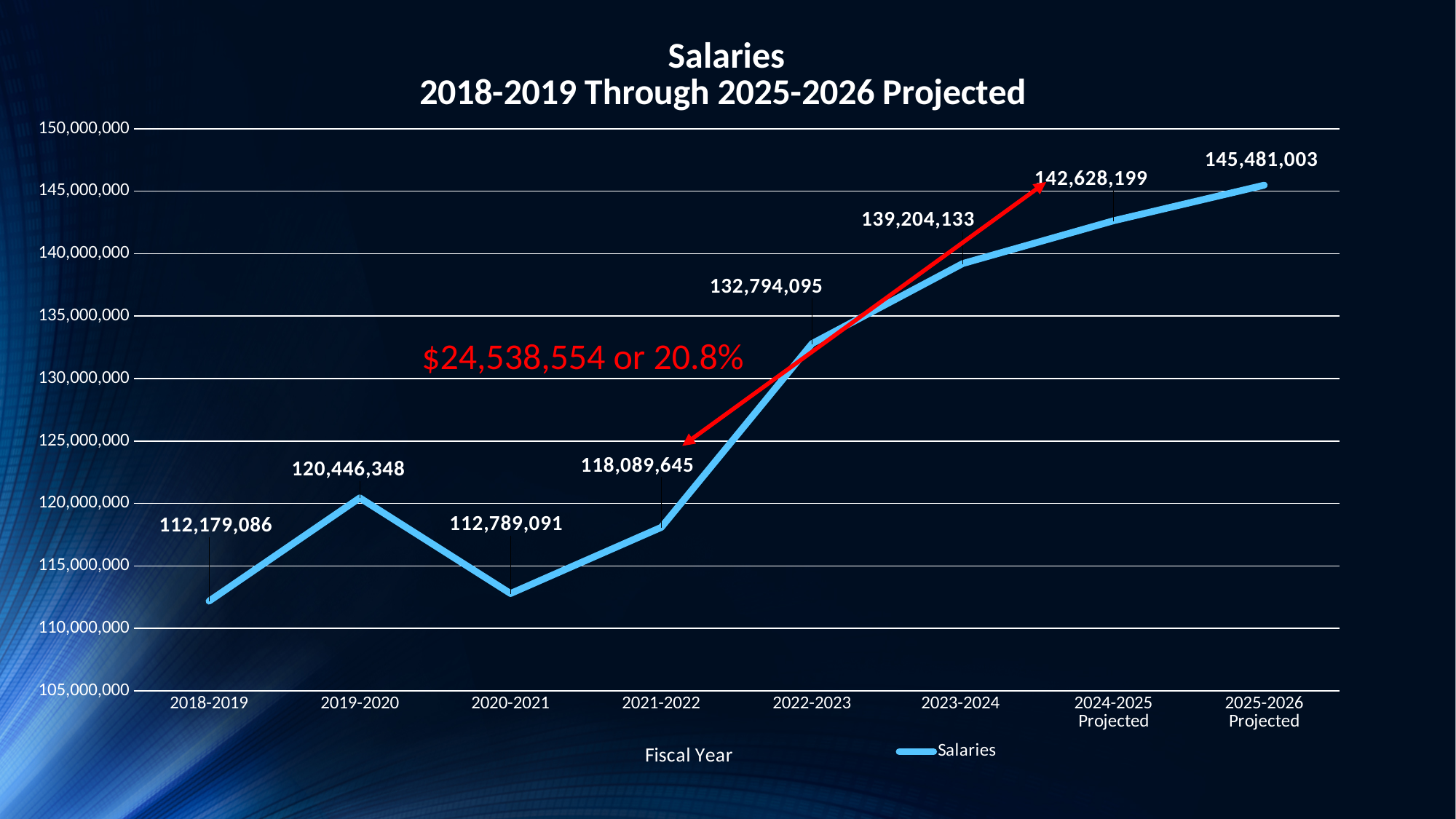
What increase does the red annotation on the chart state? $24,538,554 or 20.8% What type of chart is shown on the slide? Line chart What is the projected salary value for 2025-2026? 145,481,003 How many series does the legend list? 1 How many fiscal years are plotted on the chart? 8 What is the difference between the projected salary values for 2025-2026 and 2024-2025? 2,852,804 What is the difference between the salary values for 2019-2020 and 2018-2019? 8,267,262 Which fiscal year has the highest salary value? 2025-2026 Projected What is the salary value for 2022-2023? 132,794,095 Which is larger, the salary value for 2019-2020 or for 2021-2022? 2019-2020 What is the salary value for 2018-2019? 112,179,086 Which fiscal year has the lowest salary value? 2018-2019